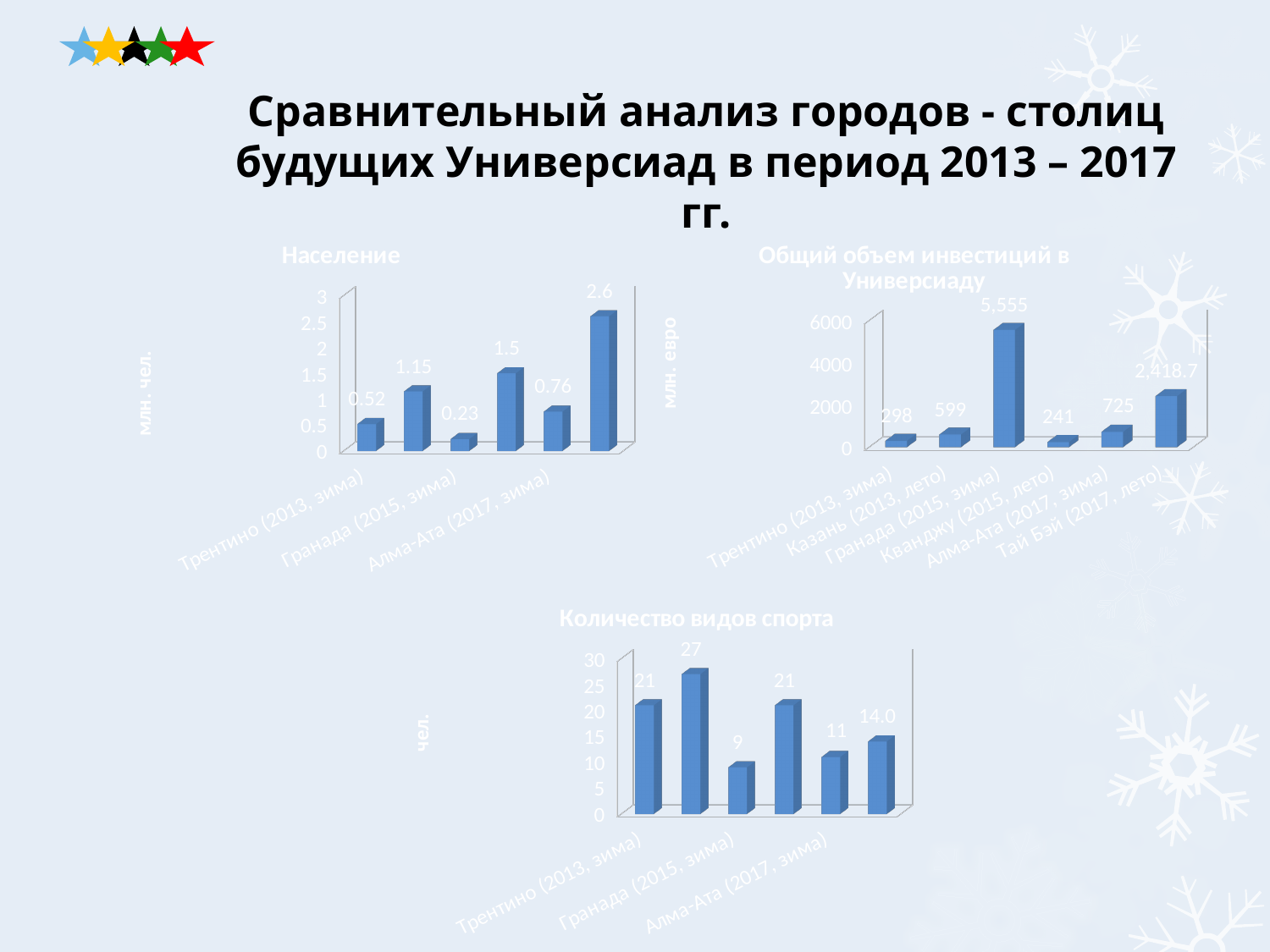
In the chart titled "Население", which category has the lowest value? Гранада (2015, зима) In the chart titled "Население", what is the value for Гранада (2015, зима)? 0.23 In the chart titled "Общий объем инвестиций в Универсиаду", what is the value for Казань (2013, лето)? 599 In the chart titled "Количество видов спорта", what is the value for Гранада (2015, зима)? 9 In the chart titled "Население", what is the value for Трентино (2013, зима)? 0.52 In the chart titled "Общий объем инвестиций в Универсиаду", which category has the highest value? Гранада (2015, зима) In the chart titled "Население", what is the difference between the values for Алма-Ата (2017, зима) and Трентино (2013, зима)? 0.24 In the chart titled "Общий объем инвестиций в Универсиаду", what is the difference between the values for Алма-Ата (2017, зима) and Трентино (2013, зима)? 427 How many bars are plotted in the chart titled "Количество видов спорта"? 6 In the chart titled "Общий объем инвестиций в Универсиаду", which category has the lowest value? Кванджу (2015, лето) What kind of chart is the one titled "Количество видов спорта"? Bar chart In the chart titled "Общий объем инвестиций в Универсиаду", which is larger: the value for Казань (2013, лето) or the value for Тай Бэй (2017, лето)? Тай Бэй (2017, лето)